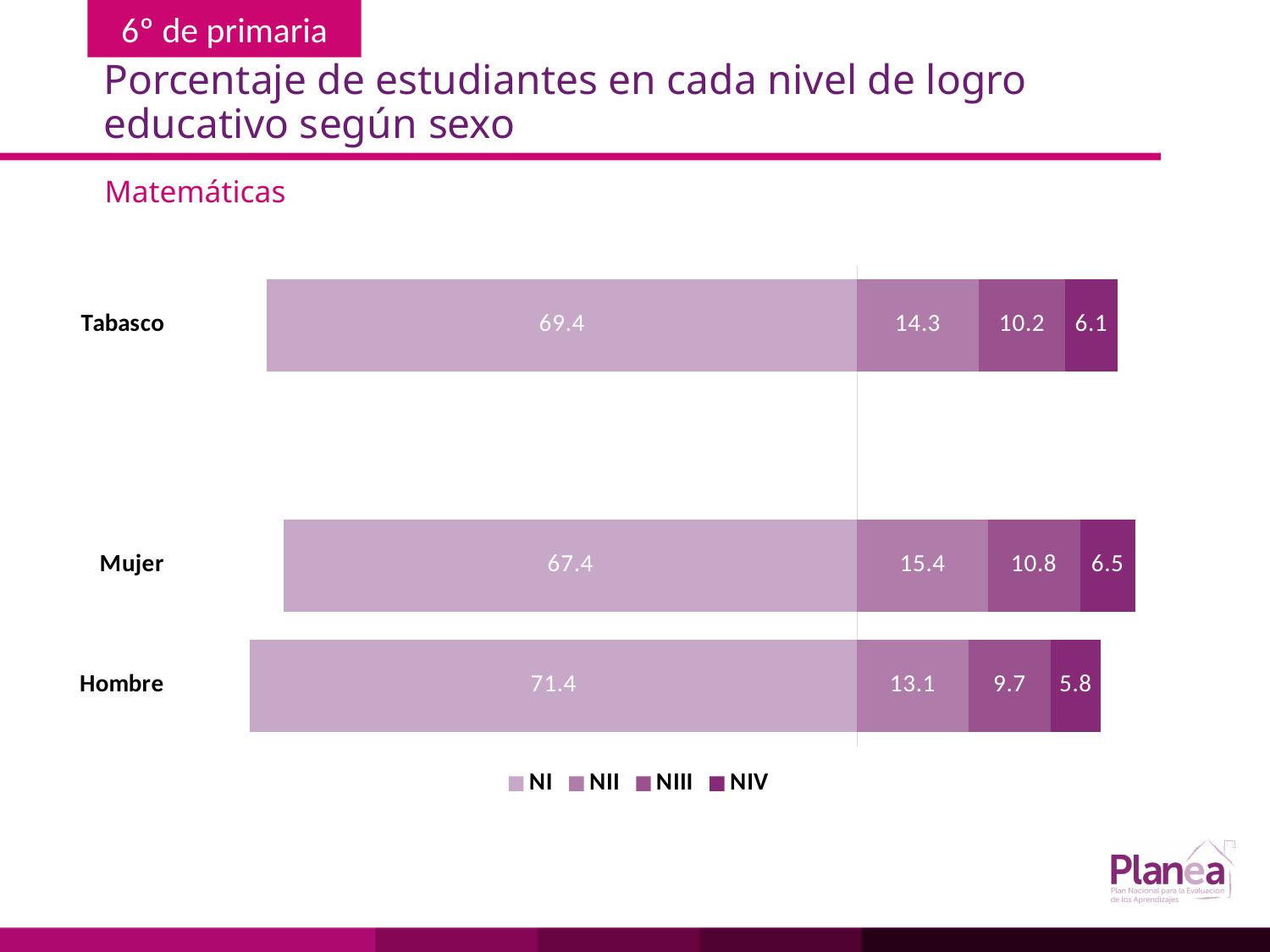
How many categories are shown on the chart? 3 What kind of chart is shown on the slide? Stacked bar chart Which category has the highest NI value? Hombre What is the total of the stacked bar for Tabasco? 100.0 What is the NIII value for Hombre? 9.7 Which is larger, the NII value for Tabasco or the NII value for Hombre? Tabasco Which category has the lowest NIV value? Hombre What is the NI value for Hombre? 71.4 What is the difference between the NI values for Hombre and Mujer? 4.0 What is the NII value for Mujer? 15.4 What is the NIV value for Tabasco? 6.1 How many series does the legend list? 4